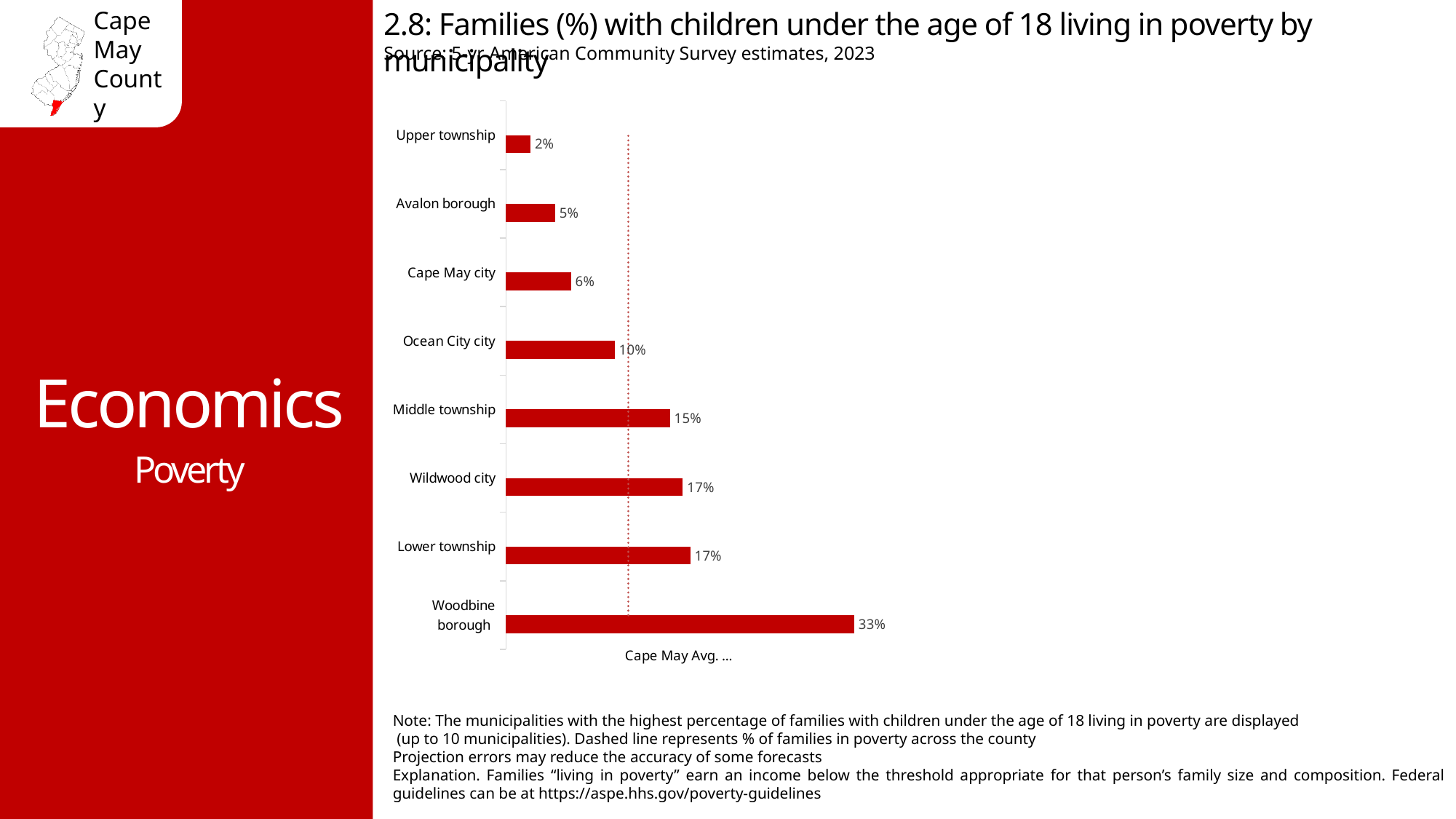
Which has a higher value, Middle township or Ocean City city? Middle township Which municipality has the highest percentage of families with children living in poverty? Woodbine borough What does the dashed vertical line in the chart represent? Cape May Avg. How many municipalities are shown in the chart? 8 What kind of chart is used on this slide? Bar chart What is the difference between the values for Cape May city and Avalon borough? 1% What is the value shown for Middle township? 15% What is the value shown for Upper township? 2% What is the value shown for Ocean City city? 10% What percentage of families with children under 18 are living in poverty in Woodbine borough? 33% Which municipality has the lowest percentage of families with children living in poverty? Upper township What is the difference between the values for Woodbine borough and Lower township? 16%